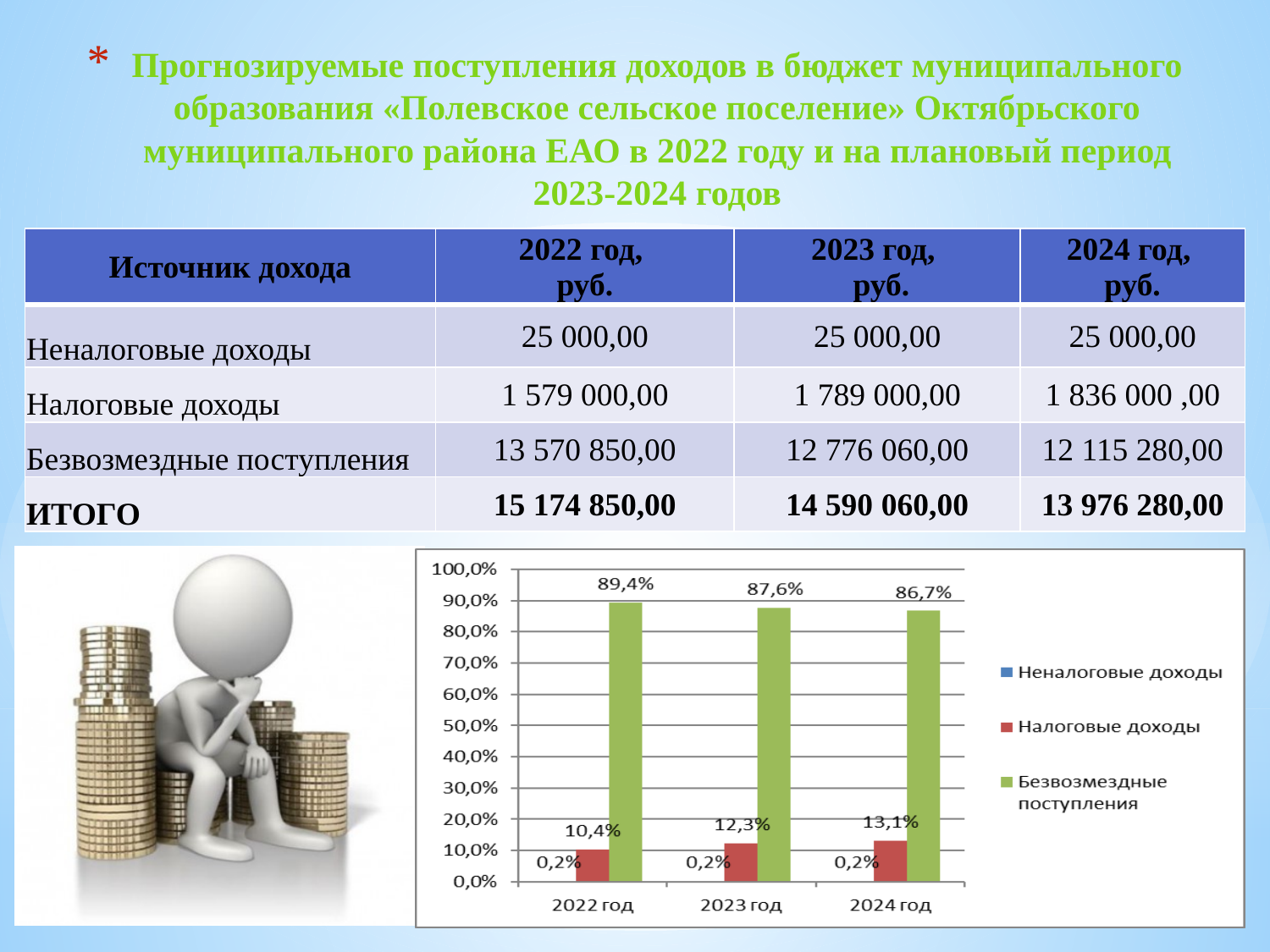
How many series does the chart legend list? 3 In which year is the share of Безвозмездные поступления the highest? 2022 год What is the value for Неналоговые доходы in 2023 год? 0,2% What is the value for Налоговые доходы in 2024 год? 13,1% Which is larger: Налоговые доходы in 2023 год or Налоговые доходы in 2024 год? Налоговые доходы in 2024 год Which colour represents Безвозмездные поступления in the chart? green What kind of chart is shown on the slide? bar chart How many year categories are shown on the x axis of the chart? 3 Does the share of Безвозмездные поступления rise or fall from 2022 год to 2024 год? fall What is the difference between the Безвозмездные поступления values for 2022 год and 2023 год? 1,8% What is the value for Безвозмездные поступления in 2022 год? 89,4% In which year is the share of Налоговые доходы the lowest? 2022 год